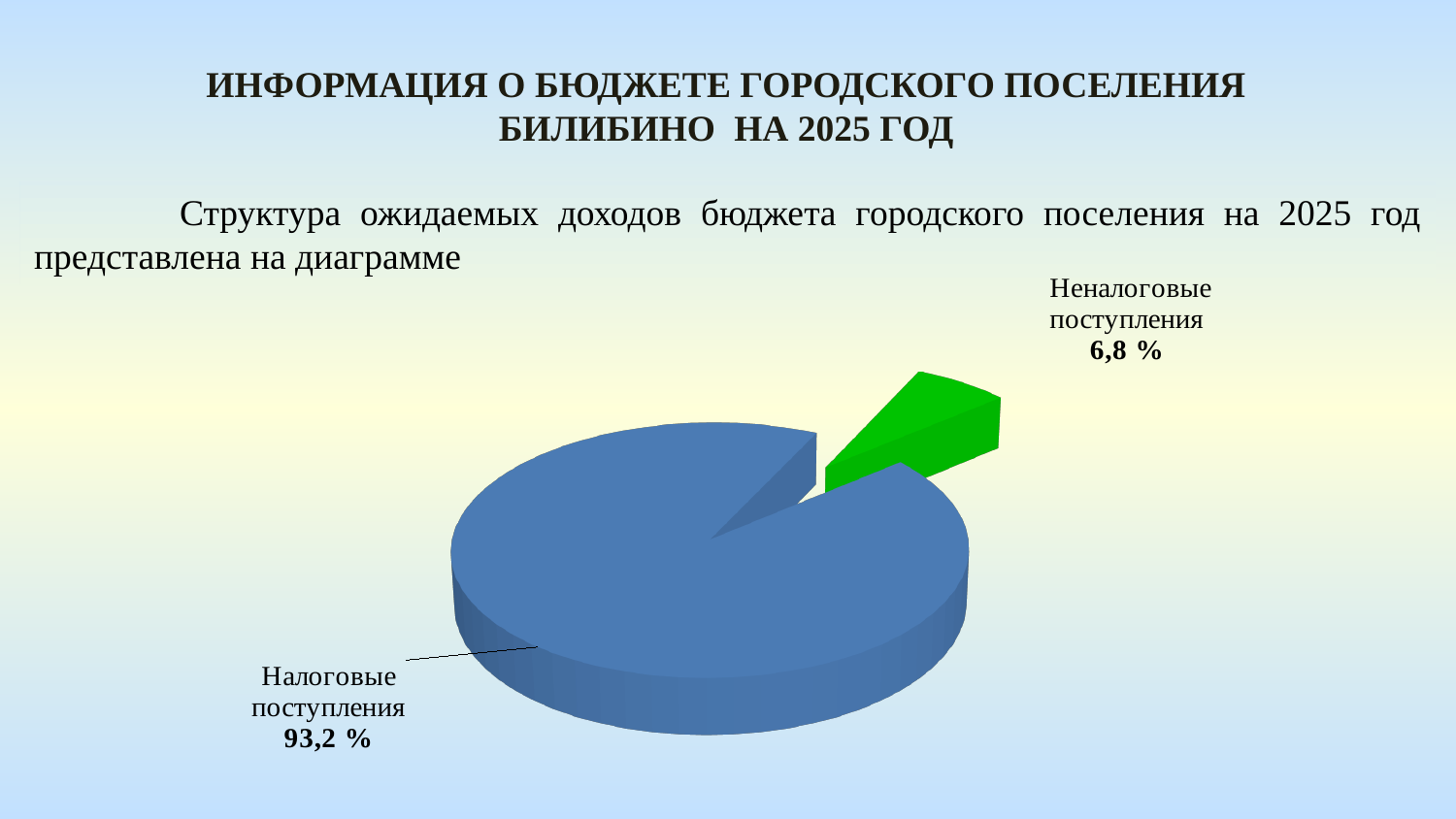
What colour is the slice for Налоговые поступления? blue What share of the pie is labelled Неналоговые поступления? 6,8 % What kind of chart is shown on the slide? pie chart Which slice of the pie is the largest? Налоговые поступления Which slice of the pie is the smallest? Неналоговые поступления What is the difference in percentage points between Налоговые поступления and Неналоговые поступления? 86,4 What is the total of the two pie slice percentages shown? 100 % How many slices does the pie chart have? 2 What share of the pie is labelled Налоговые поступления? 93,2 % Which is larger: Налоговые поступления or Неналоговые поступления? Налоговые поступления What colour is the slice for Неналоговые поступления? green